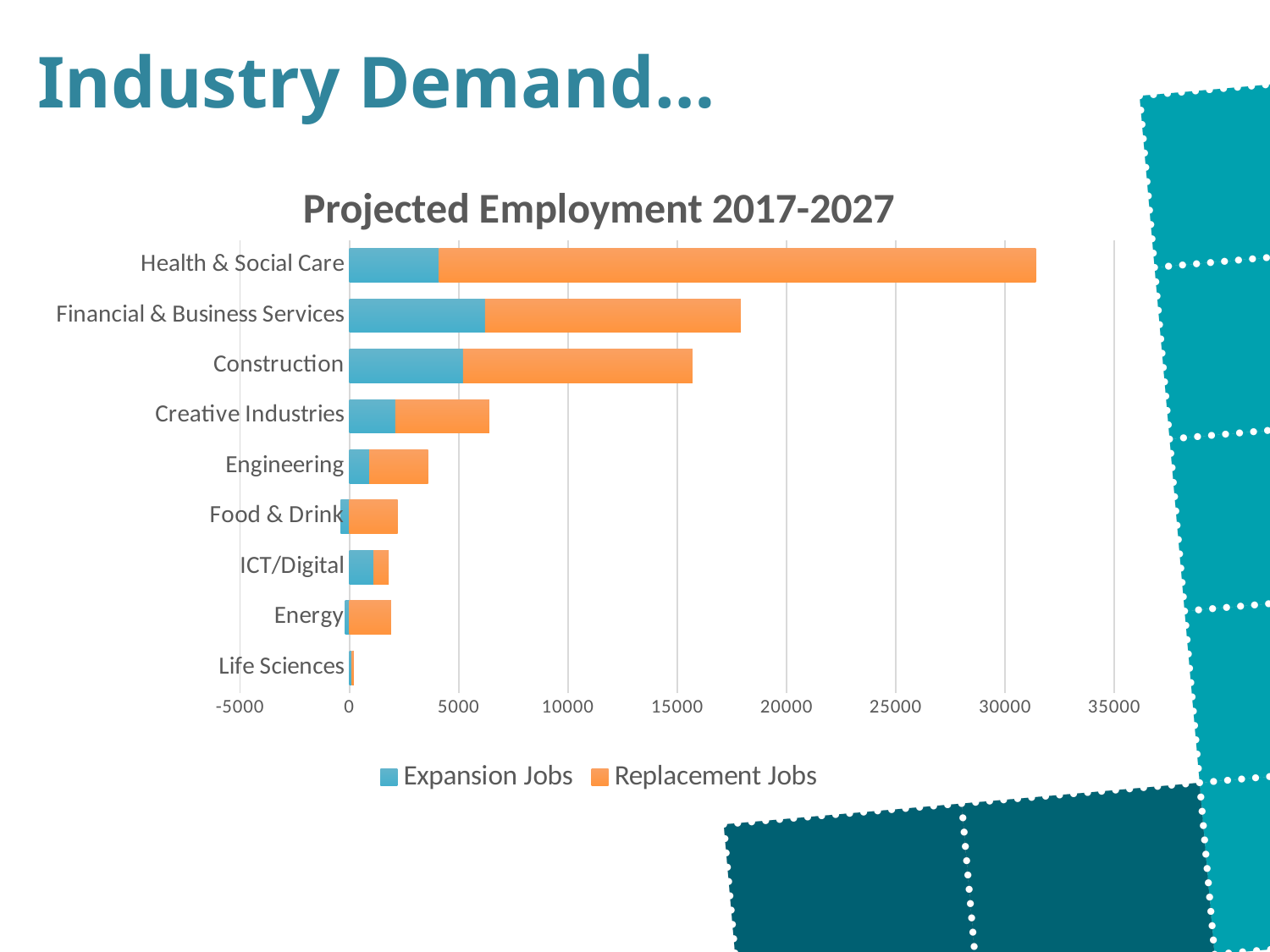
How many industry categories are shown on the chart? 9 Is the total bar for Financial & Business Services greater or less than 15000? greater Which industry has the largest total projected employment bar? Health & Social Care How many series does the legend list? 2 What is the title of the chart? Projected Employment 2017-2027 Is the total bar for Health & Social Care greater or less than 30000? greater Is the total bar for Engineering greater or less than 5000? less Which industry has the largest Expansion Jobs segment? Financial & Business Services Which industry has the smallest total projected employment bar? Life Sciences Which has the larger total bar, Financial & Business Services or Construction? Financial & Business Services Which colour represents Replacement Jobs in the legend? Orange What type of chart is shown on the slide? Bar chart